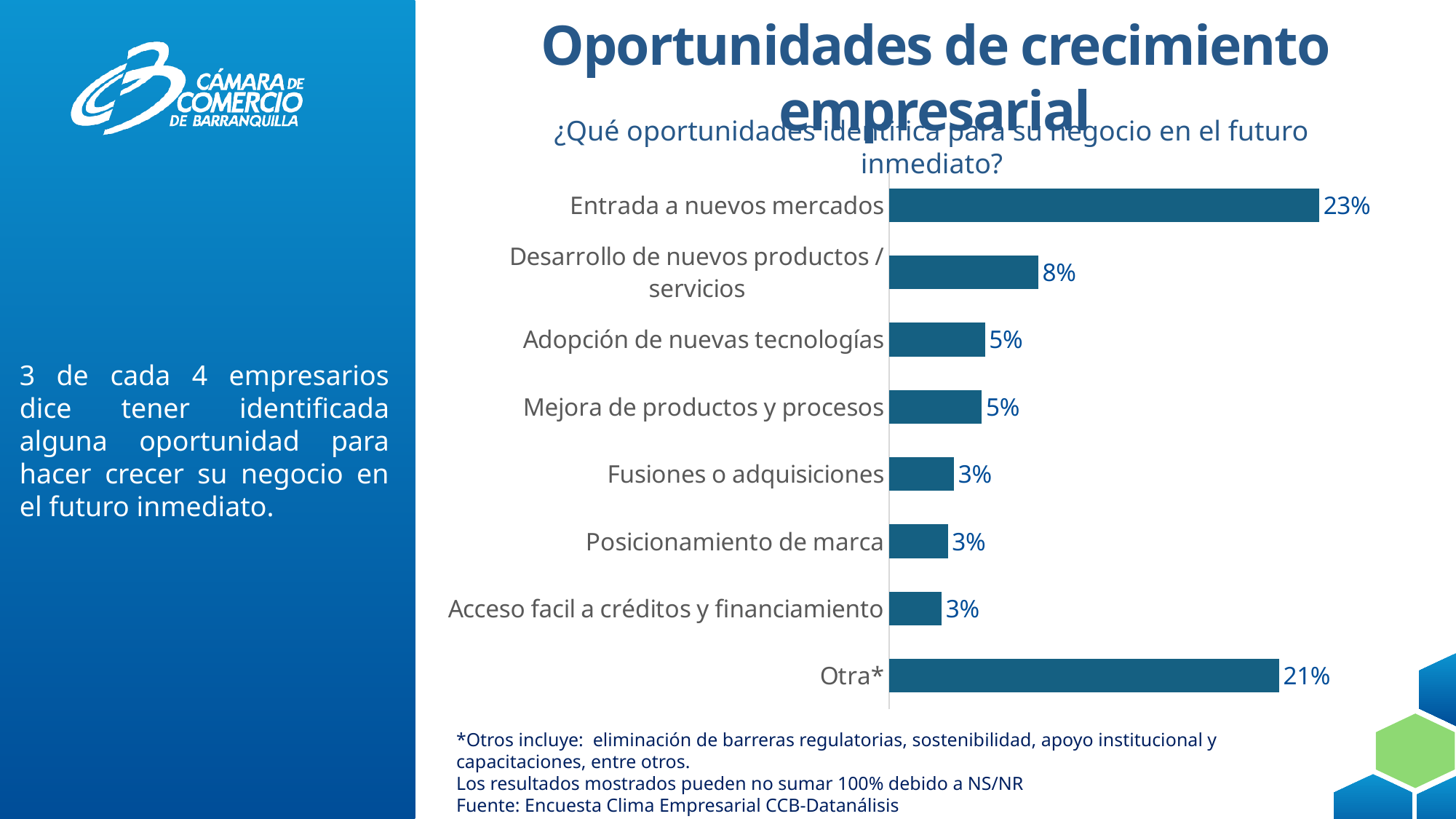
What is the value for Desarrollo de nuevos productos / servicios? 8% What is the value for Otra*? 21% What question does the chart's subtitle ask? ¿Qué oportunidades identifica para su negocio en el futuro inmediato? How many categories are shown in the chart? 8 What is the value for Adopción de nuevas tecnologías? 5% What is the difference between Desarrollo de nuevos productos / servicios and Adopción de nuevas tecnologías? 3% What is the value for Fusiones o adquisiciones? 3% What is the difference between Entrada a nuevos mercados and Otra*? 2% Which category has the highest value? Entrada a nuevos mercados Which is larger, Desarrollo de nuevos productos / servicios or Mejora de productos y procesos? Desarrollo de nuevos productos / servicios What kind of chart is shown on the slide? Bar chart What is the value for Entrada a nuevos mercados? 23%